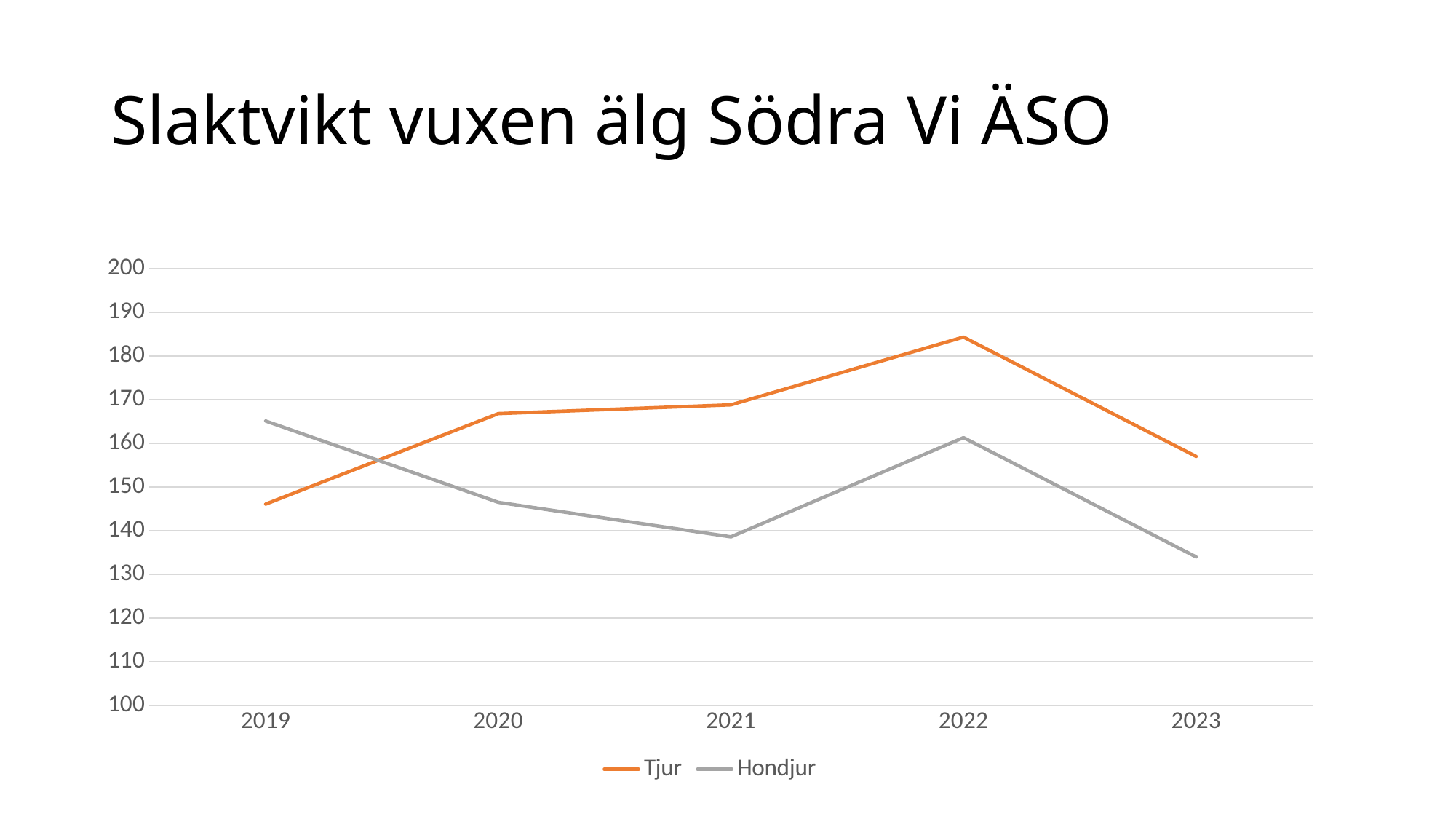
Is the Hondjur value for 2023 greater or less than 140? less What is the title of the slide? Slaktvikt vuxen älg Södra Vi ÄSO In 2023, which series has the larger value, Tjur or Hondjur? Tjur How many series does the legend list? 2 In 2019, which series has the larger value, Tjur or Hondjur? Hondjur In which year is the Tjur value lowest? 2019 Does the Tjur line rise or fall from 2019 to 2022? rise In which year is the Tjur value highest? 2022 What kind of chart is shown on the slide? line chart How many years are plotted along the x axis? 5 In which year is the Hondjur value lowest? 2023 Is the Tjur value for 2022 greater or less than 180? greater